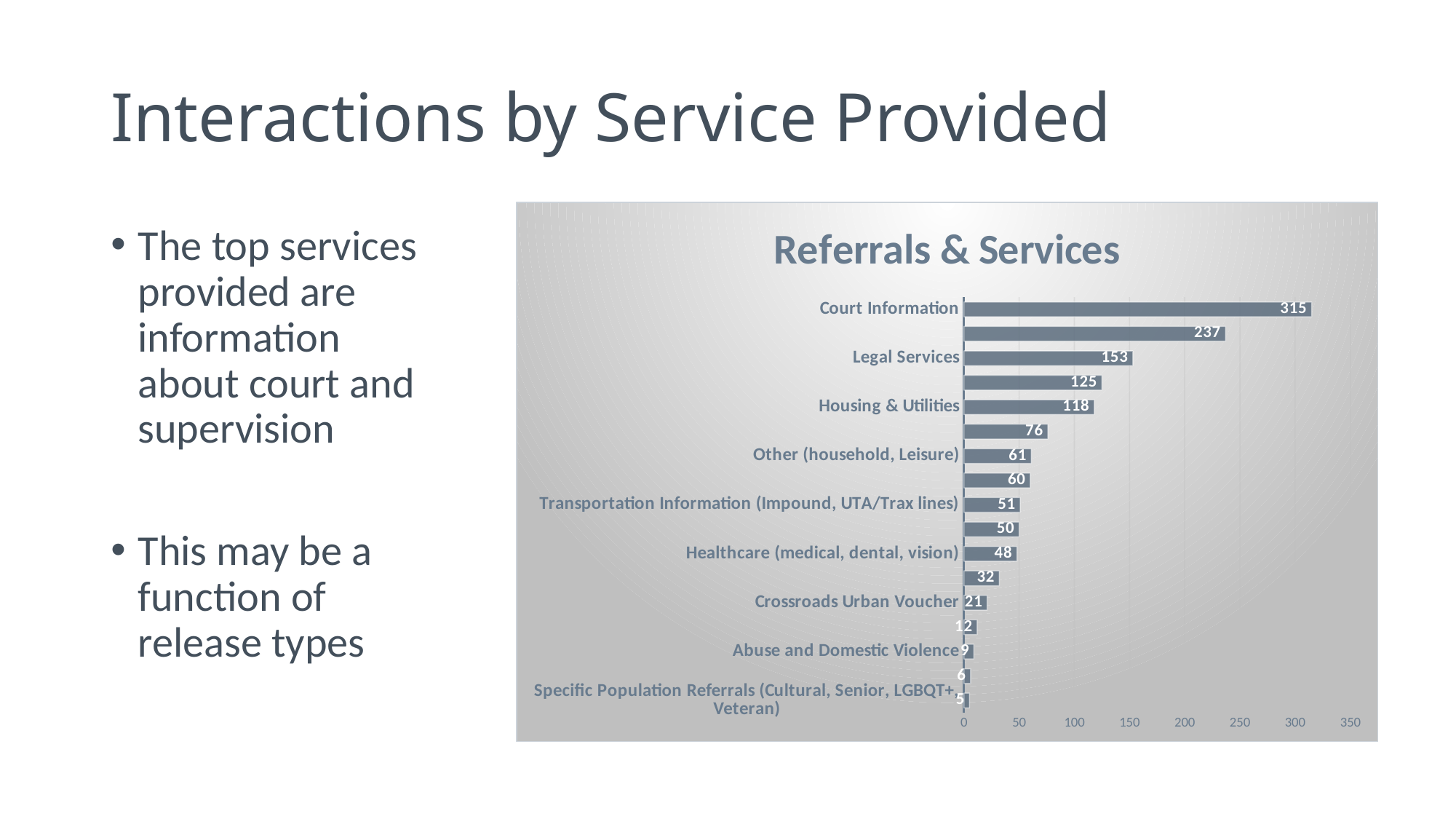
Which category has the highest value in the Referrals & Services chart? Court Information What type of chart is the Referrals & Services chart? bar chart What is the value for Legal Services in the Referrals & Services chart? 153 What is the value for Court Information in the Referrals & Services chart? 315 Which category has the lowest value in the Referrals & Services chart? Specific Population Referrals (Cultural, Senior, LGBQT+, Veteran) What is the value for Crossroads Urban Voucher in the Referrals & Services chart? 21 What is the value for Housing & Utilities in the Referrals & Services chart? 118 What is the value for Healthcare (medical, dental, vision) in the Referrals & Services chart? 48 How many bars are plotted in the Referrals & Services chart? 17 What is the difference between the values for Court Information and Legal Services in the Referrals & Services chart? 162 Is the value for Transportation Information (Impound, UTA/Trax lines) greater or less than 100 in the Referrals & Services chart? less Which is larger in the Referrals & Services chart: Housing & Utilities or Other (household, Leisure)? Housing & Utilities